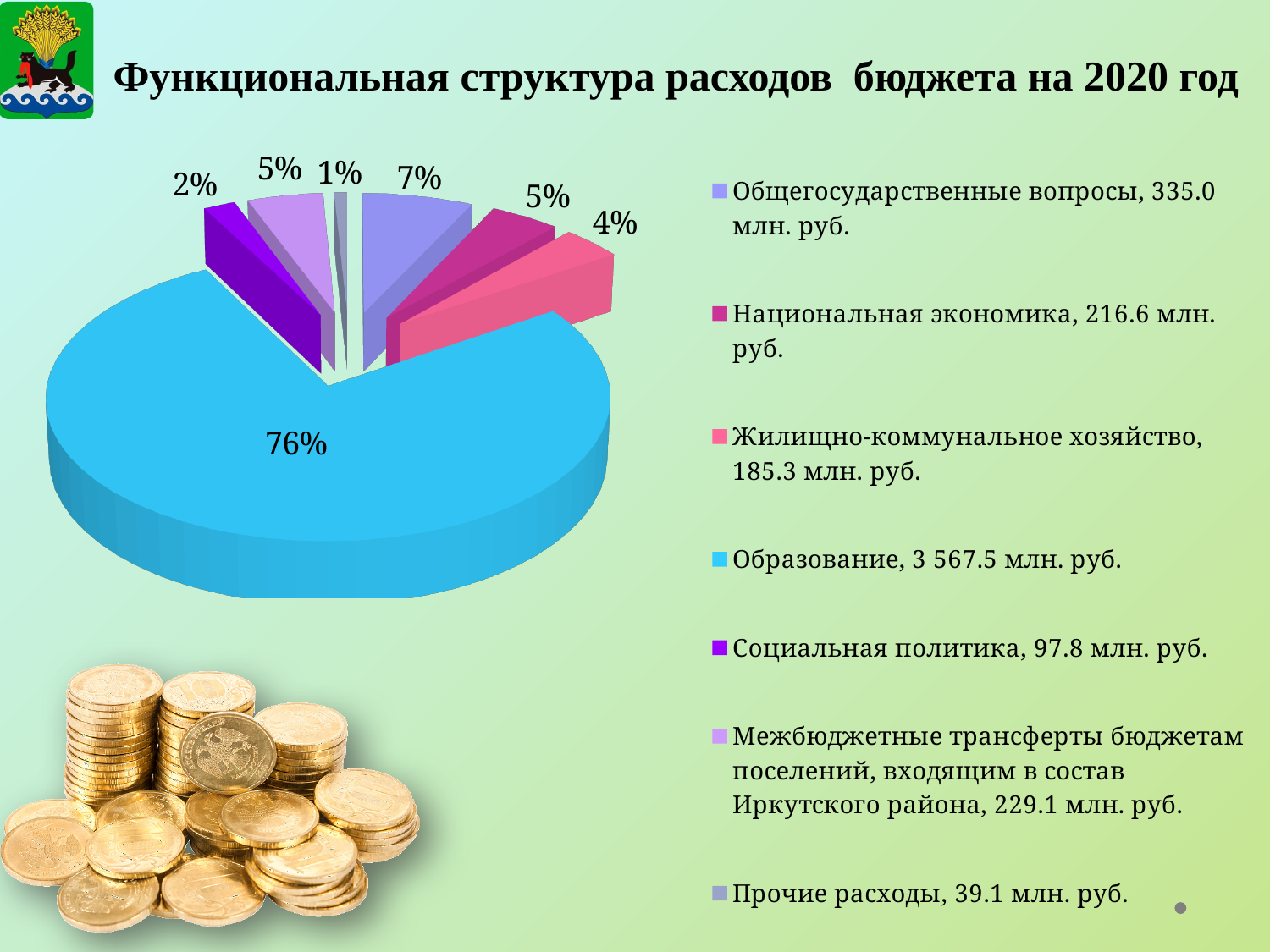
Which category has the smallest share of the pie chart? Прочие расходы What kind of chart is shown on the slide? pie chart What is the value for Прочие расходы according to the legend? 39.1 млн. руб. How many categories does the pie chart show? 7 What is the value for Образование according to the legend? 3 567.5 млн. руб. What is the value for Национальная экономика according to the legend? 216.6 млн. руб. What share of the pie does Социальная политика account for? 2% Which category has the largest share of the pie chart? Образование Which is larger: Общегосударственные вопросы or Жилищно-коммунальное хозяйство? Общегосударственные вопросы What is the title of the slide's chart? Функциональная структура расходов бюджета на 2020 год What is the difference between Общегосударственные вопросы (335.0 млн. руб.) and Национальная экономика (216.6 млн. руб.)? 118.4 млн. руб. What share of the pie does Образование account for? 76%